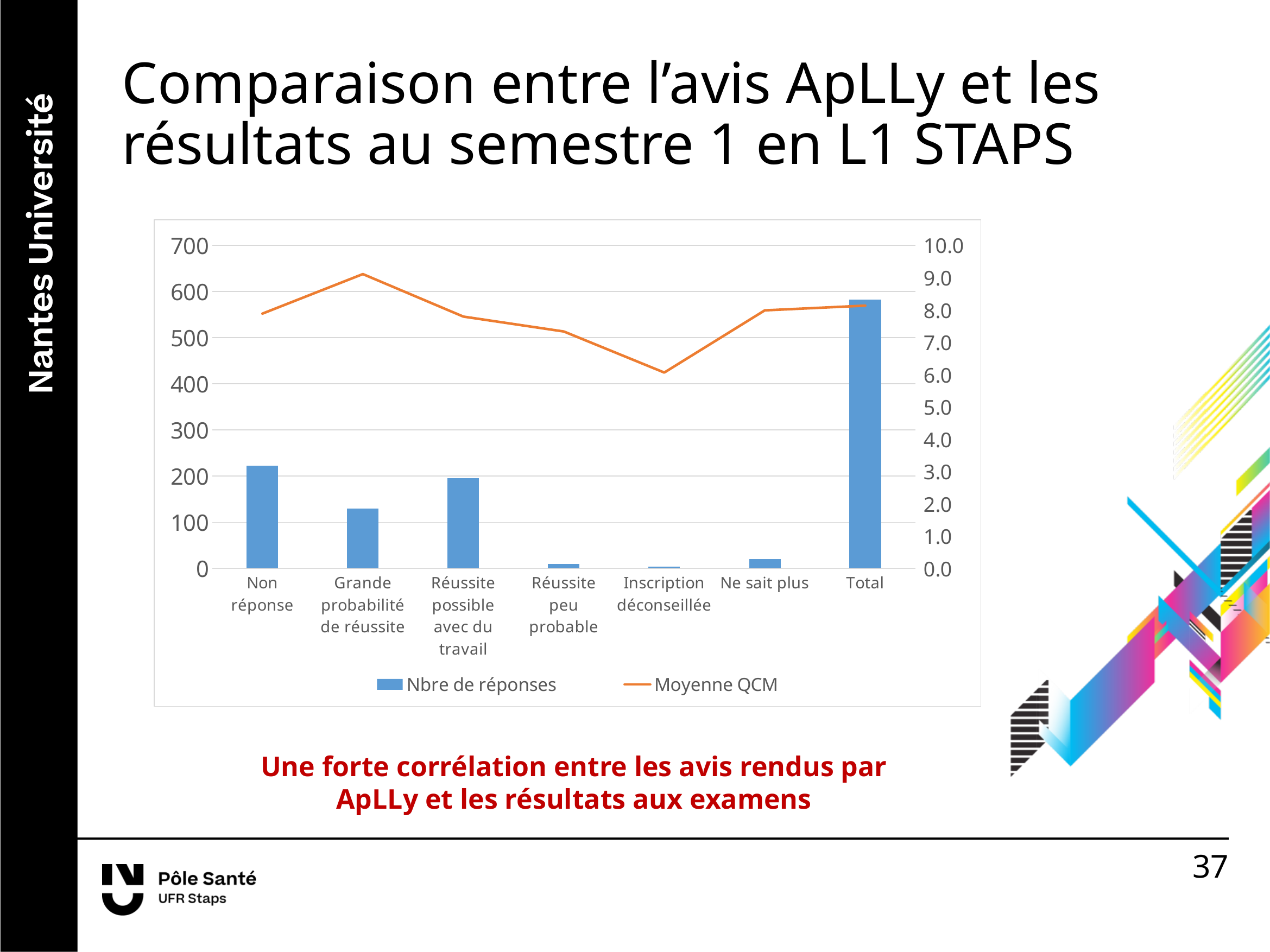
Which has more Nbre de réponses: Non réponse or Grande probabilité de réussite? Non réponse What kind of chart is shown on the slide? Combined bar and line chart Which category has the lowest Moyenne QCM on the line? Inscription déconseillée Is the Nbre de réponses for Non réponse greater or less than 200? greater Is the Nbre de réponses for Total greater or less than 500? greater How many series does the chart legend list? 2 Which category has the highest bar for Nbre de réponses? Total What are the two series named in the chart legend? Nbre de réponses and Moyenne QCM Is the Moyenne QCM for Inscription déconseillée greater or less than 7.0? less How many categories are shown on the x axis of the chart? 7 Which category has the lowest bar for Nbre de réponses? Inscription déconseillée Which category has the highest Moyenne QCM on the line? Grande probabilité de réussite